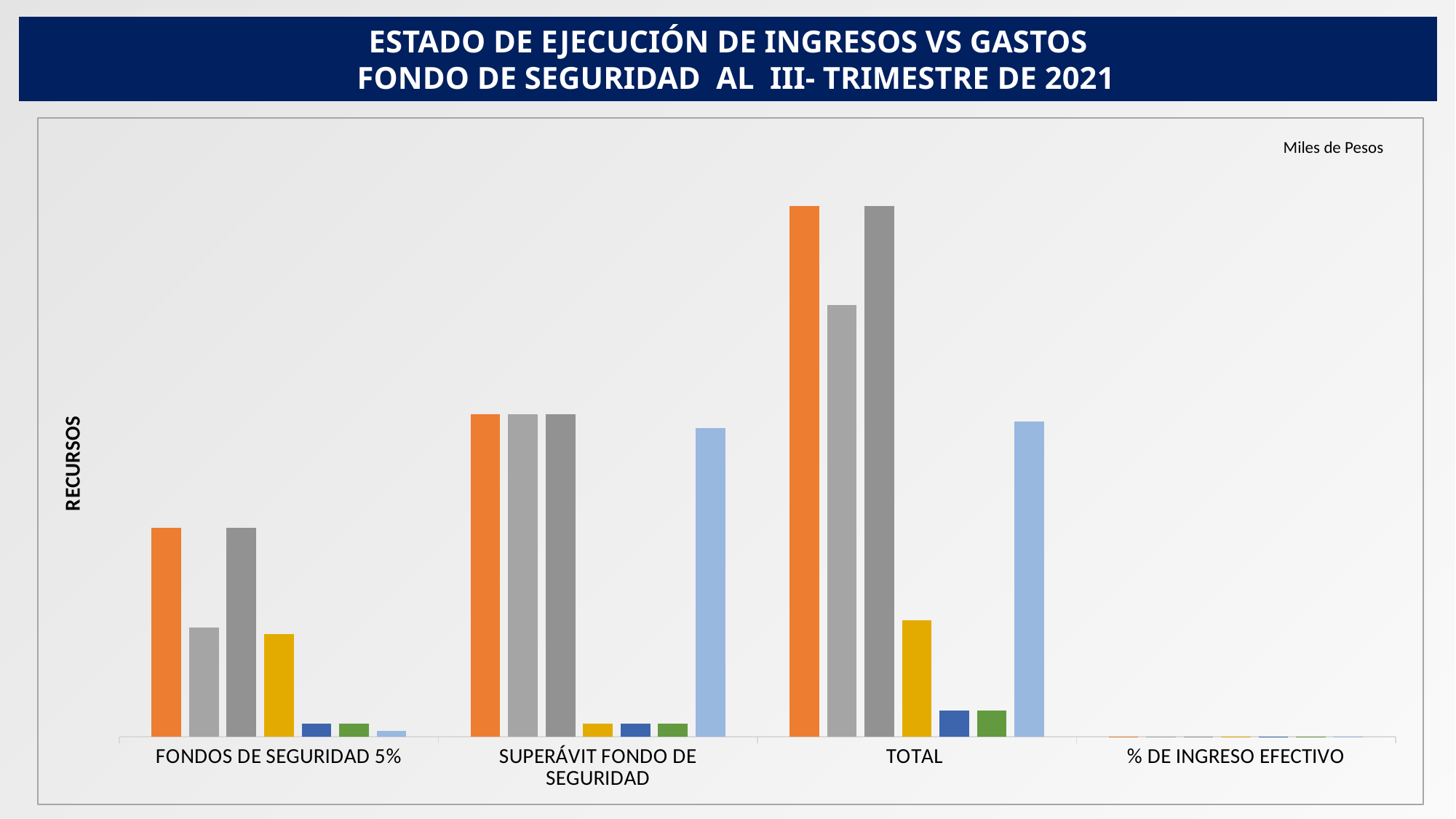
What unit note is printed in the top right corner of the chart area? Miles de Pesos Which category on the x axis has the tallest bars? TOTAL What kind of chart is shown on the slide? bar chart Is the tallest bar in the TOTAL category taller or shorter than the tallest bar in the SUPERÁVIT FONDO DE SEGURIDAD category? taller Which category on the x axis has the smallest bars? % DE INGRESO EFECTIVO What is the label on the vertical axis of the chart? RECURSOS How many categories are shown on the x axis of the chart? 4